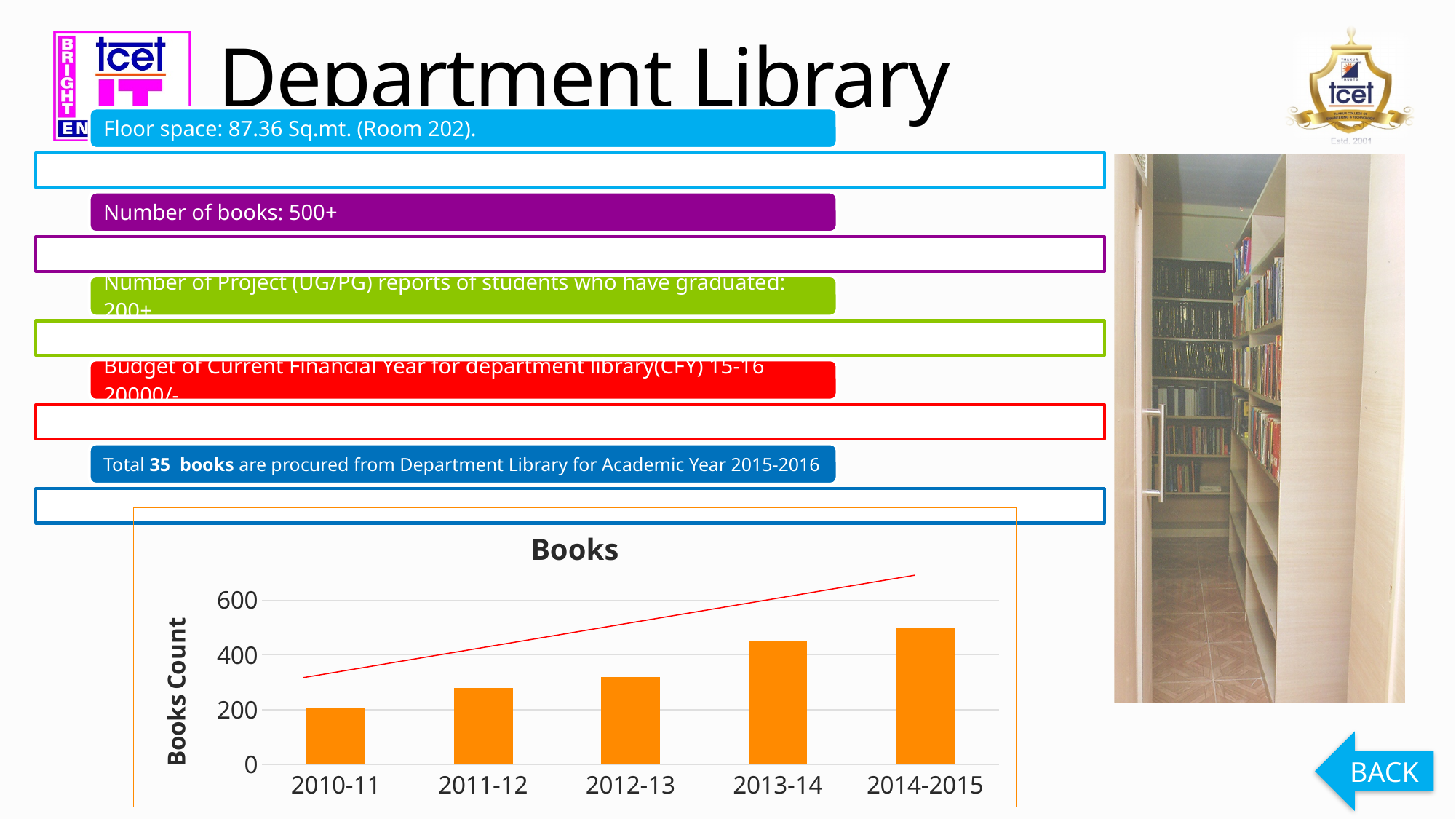
Which has a larger books count, 2013-14 or 2011-12? 2013-14 Which academic year has the lowest books count? 2010-11 Which academic year has the highest books count? 2014-2015 Do the books count values rise or fall from 2010-11 to 2014-2015? rise How many academic years are shown on the x axis of the chart? 5 Is the books count for 2014-2015 greater or less than 400? greater What is the label on the vertical axis of the chart? Books Count Is the books count for 2012-13 greater or less than 400? less What kind of chart is shown on the slide? bar chart Is the books count for 2011-12 greater or less than 200? greater What is the title of the chart? Books